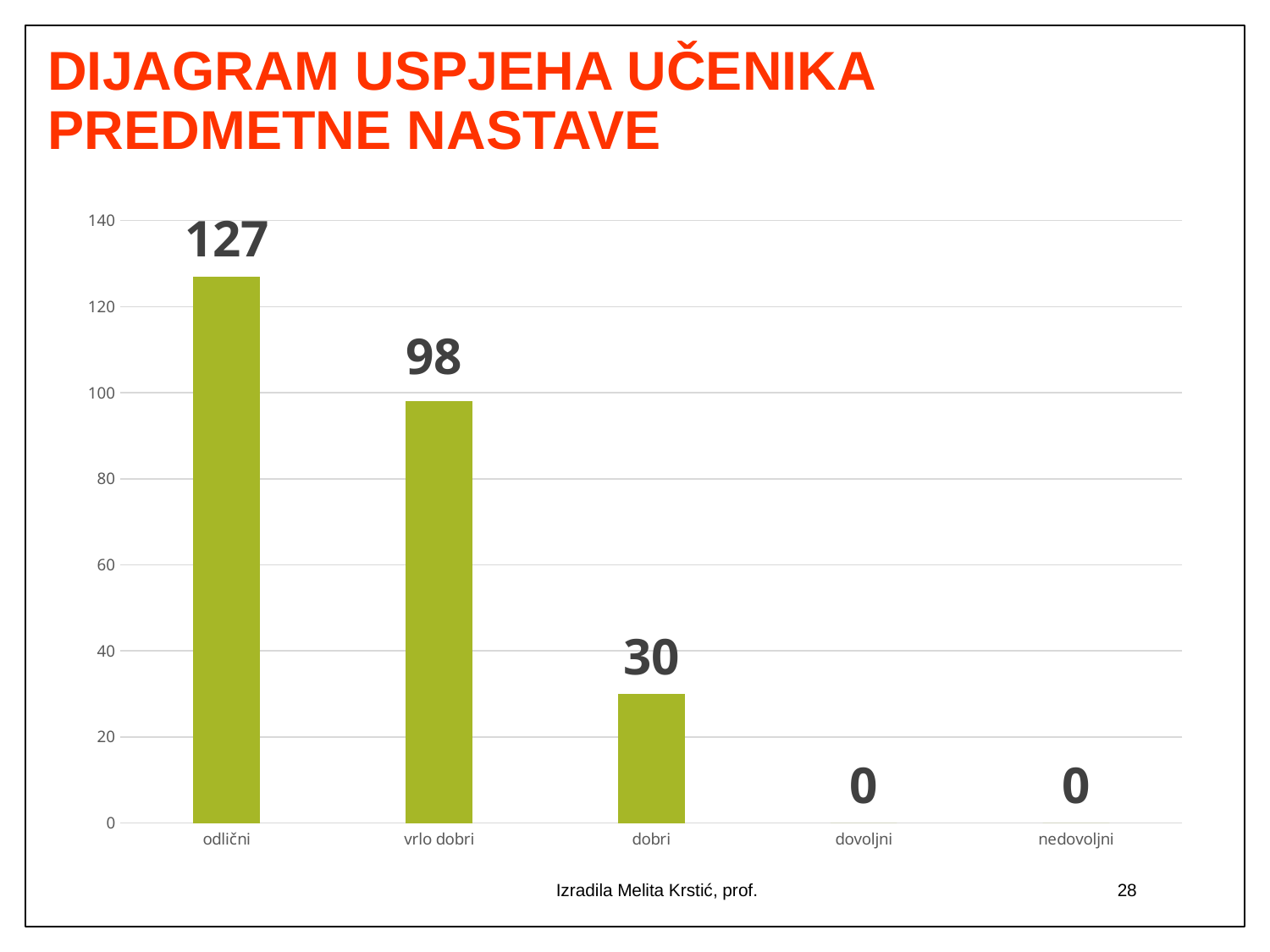
What is the value for vrlo dobri? 98 Do the values rise or fall from left to right along the x axis? fall What is the value for dovoljni? 0 What kind of chart is shown on the slide? bar chart What is the value for odlični? 127 What is the difference between the values for vrlo dobri and dobri? 68 How many categories are shown on the x axis? 5 What is the difference between the values for odlični and vrlo dobri? 29 Is the value for odlični greater or less than 120? greater Which category has the highest value? odlični What is the value for dobri? 30 Which is larger, the value for vrlo dobri or the value for dobri? vrlo dobri